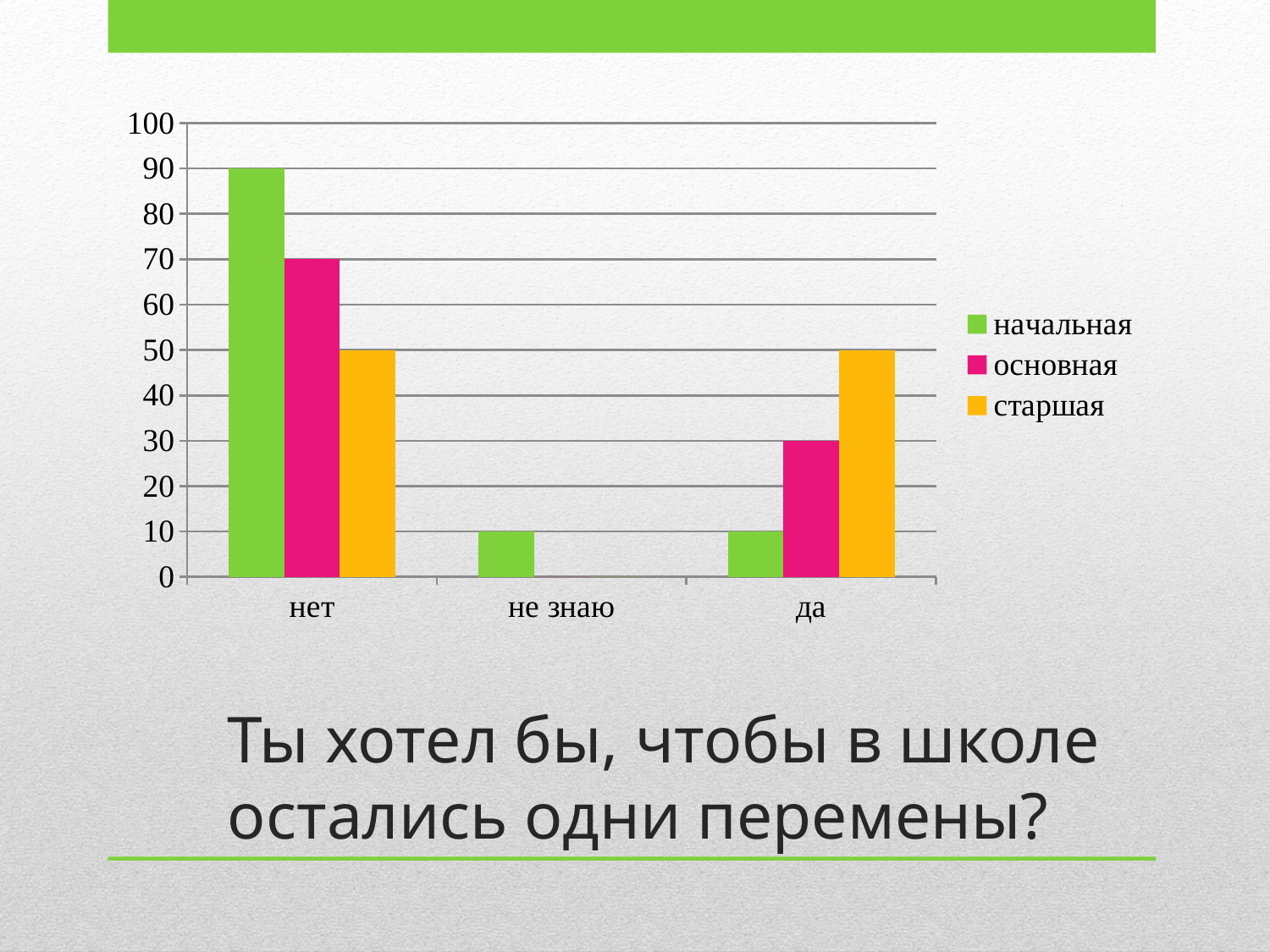
Which category has the highest value for начальная? нет What is the value for основная in the category да? 30 What is the value for основная in the category нет? 70 What is the value for начальная in the category нет? 90 Which series is shown in orange in the legend? старшая How many series does the legend list? 3 What kind of chart is shown on the slide? bar chart Which series has the lowest value in the category нет? старшая Which is larger in the category да: the value for основная or the value for старшая? старшая What is the difference between the начальная and старшая values in the category нет? 40 How many categories are shown on the x axis? 3 What is the value for старшая in the category да? 50